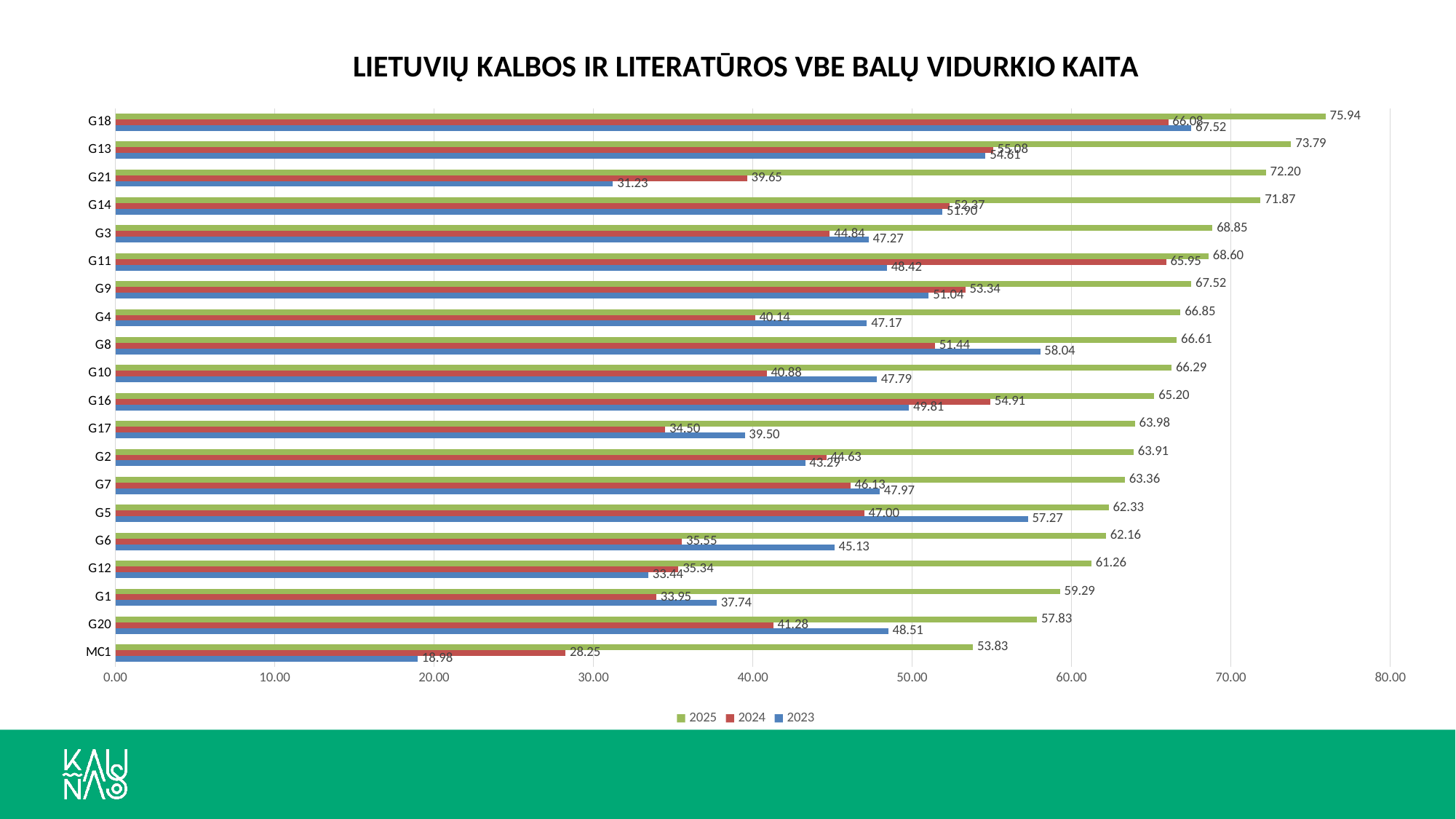
What is the difference between the 2024 and 2023 values for G21? 8.42 For G5, which is larger: the 2023 value or the 2024 value? 2023 What is the 2025 value for G21? 72.20 What is the 2023 value for MC1? 18.98 Is the 2025 value for G20 greater or less than 60.00? less Which category has the lowest 2025 value? MC1 What is the 2024 value for G17? 34.50 Which category has the highest 2025 value? G18 What is the difference between the 2025 and 2023 values for G8? 8.57 How many categories are shown on the chart? 20 How many series does the legend list? 3 What kind of chart is shown on the slide? bar chart